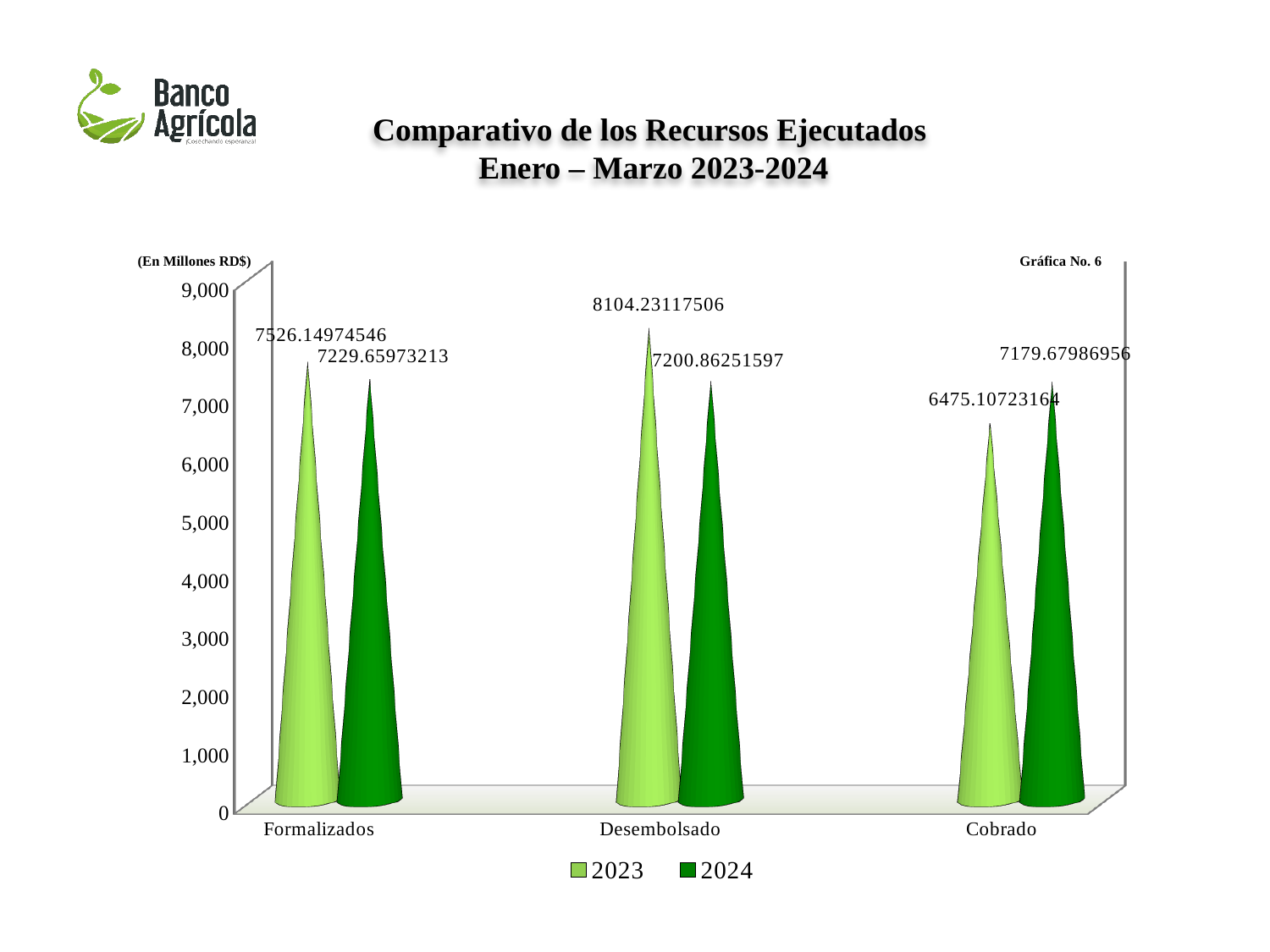
How many series does the legend list? 2 Which category has the highest value in the 2023 series? Desembolsado What is the value for Cobrado in the 2023 series? 6475.10723164 Which category has the lowest value in the 2023 series? Cobrado Which category has the lowest value in the 2024 series? Cobrado What kind of chart is shown on the slide? Bar chart What is the value for Formalizados in the 2023 series? 7526.14974546 For Cobrado, which series has the larger value, 2023 or 2024? 2024 What is the difference between the 2024 and 2023 values for Cobrado? 704.57263792 What is the difference between the 2023 and 2024 values for Desembolsado? 903.36865909 How many categories are shown on the x axis? 3 What is the value for Desembolsado in the 2024 series? 7200.86251597